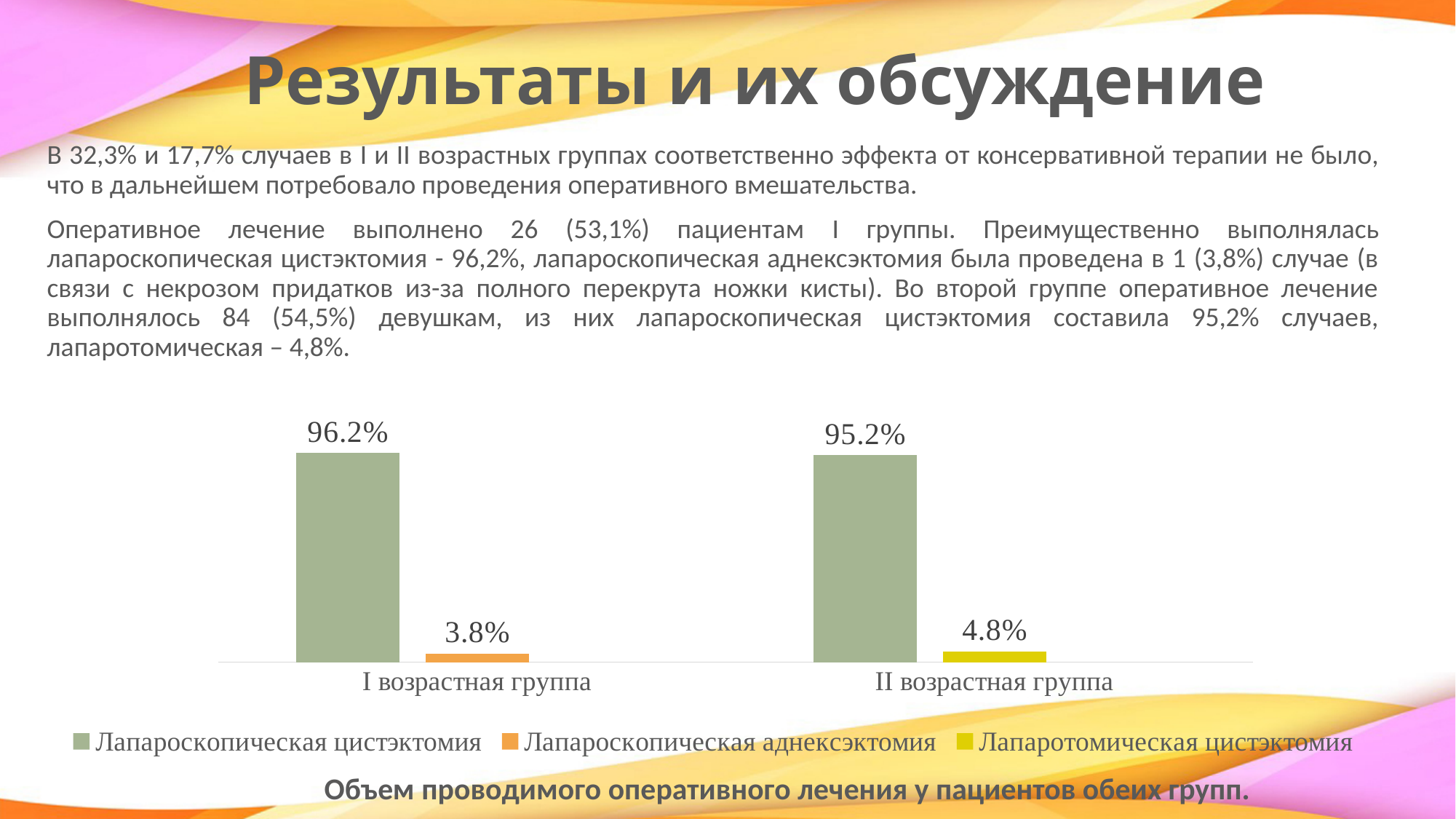
How many age-group categories are shown on the x axis? 2 What is the value of Лапароскопическая аднексэктомия for I возрастная группа? 3.8% What is the value of Лапароскопическая цистэктомия for II возрастная группа? 95.2% What type of chart is shown on the slide? bar chart Which series has the highest value in I возрастная группа? Лапароскопическая цистэктомия How many series does the legend list? 3 What is the value of Лапароскопическая цистэктомия for I возрастная группа? 96.2% What is the value of Лапаротомическая цистэктомия for II возрастная группа? 4.8% What is the difference between Лапароскопическая цистэктомия in I возрастная группа and in II возрастная группа? 1.0% What is the caption printed below the chart? Объем проводимого оперативного лечения у пациентов обеих групп. Which is larger: Лапароскопическая аднексэктомия in I возрастная группа or Лапаротомическая цистэктомия in II возрастная группа? Лапаротомическая цистэктомия in II возрастная группа Which series has the lowest value in II возрастная группа? Лапаротомическая цистэктомия